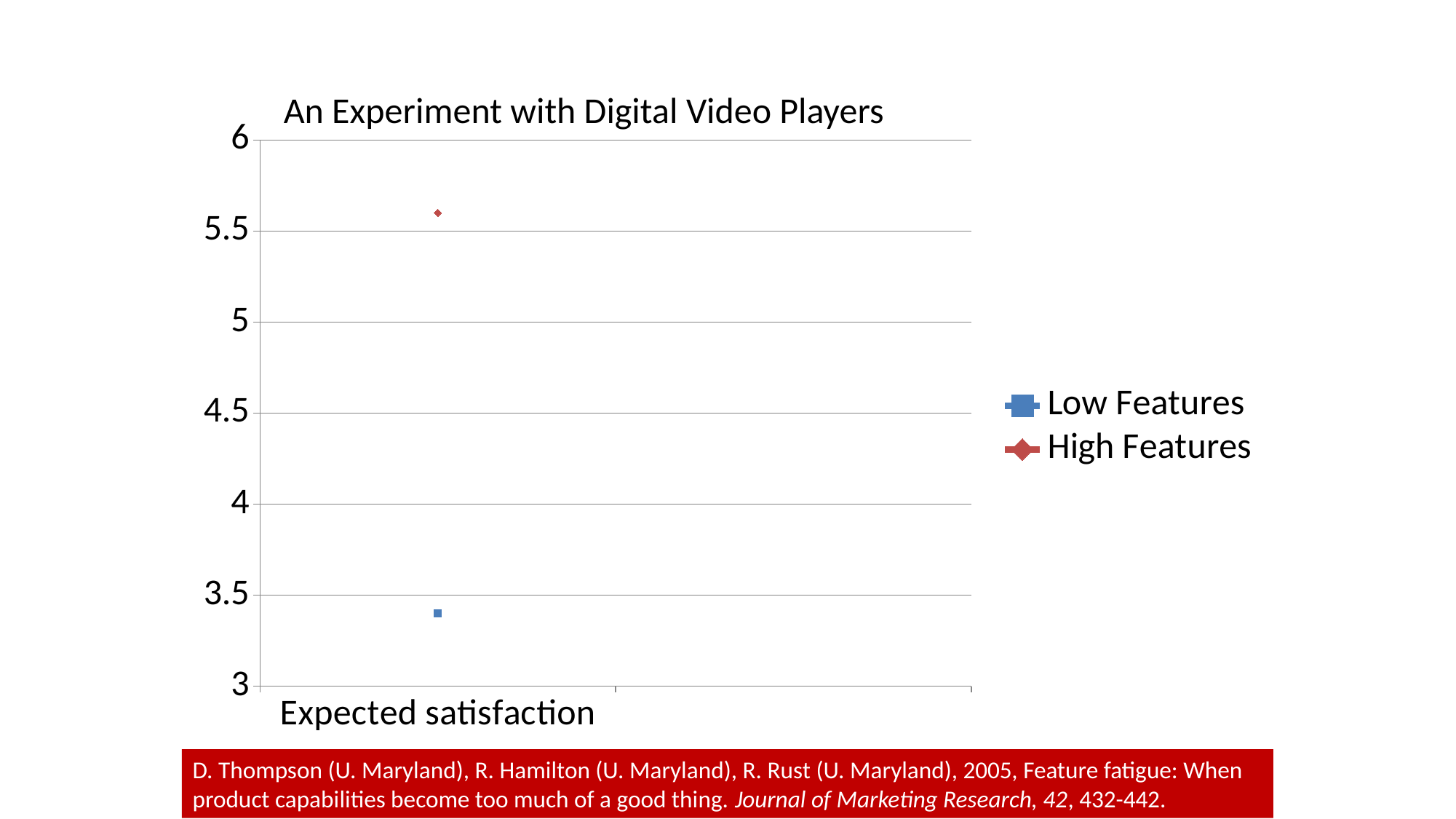
Which series has the lowest plotted value? Low Features What is the category label shown on the x axis? Expected satisfaction What is the title of the chart? An Experiment with Digital Video Players Which series has the highest plotted value? High Features Is the value for Low Features greater or less than 3? greater Is the value for High Features greater or less than 5? greater How many series does the chart legend list? 2 How many categories are plotted on the x axis? 1 What are the two series named in the legend? Low Features and High Features Which series has the higher expected satisfaction value, Low Features or High Features? High Features What is the lowest value shown on the vertical axis? 3 Is the value for Low Features greater or less than 4? less